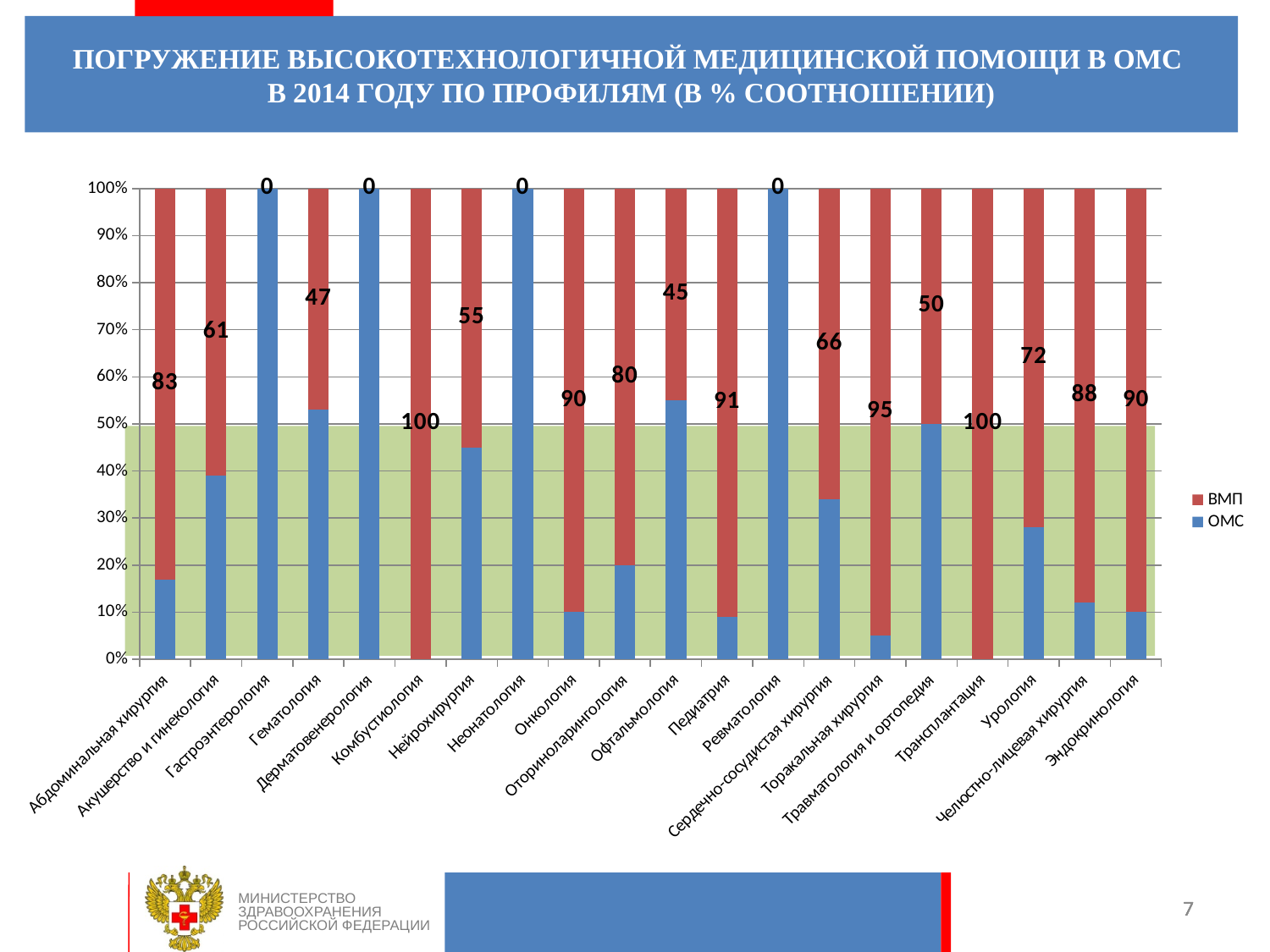
What is the ВМП value labelled for Гематология? 47 Which series is shown in blue according to the legend? ОМС What is the ВМП value labelled for Урология? 72 What kind of chart is shown on the slide? stacked bar chart Is the ОМС share for Абдоминальная хирургия greater or less than 20%? less What is the ВМП value labelled for Гастроэнтерология? 0 Which has a higher ВМП value: Офтальмология or Оториноларингология? Оториноларингология What is the ВМП value labelled for Онкология? 90 What is the ВМП value labelled for Торакальная хирургия? 95 What is the difference between the ВМП values labelled for Абдоминальная хирургия and Акушерство и гинекология? 22 How many series does the legend list? 2 How many profile categories are shown on the x axis? 20